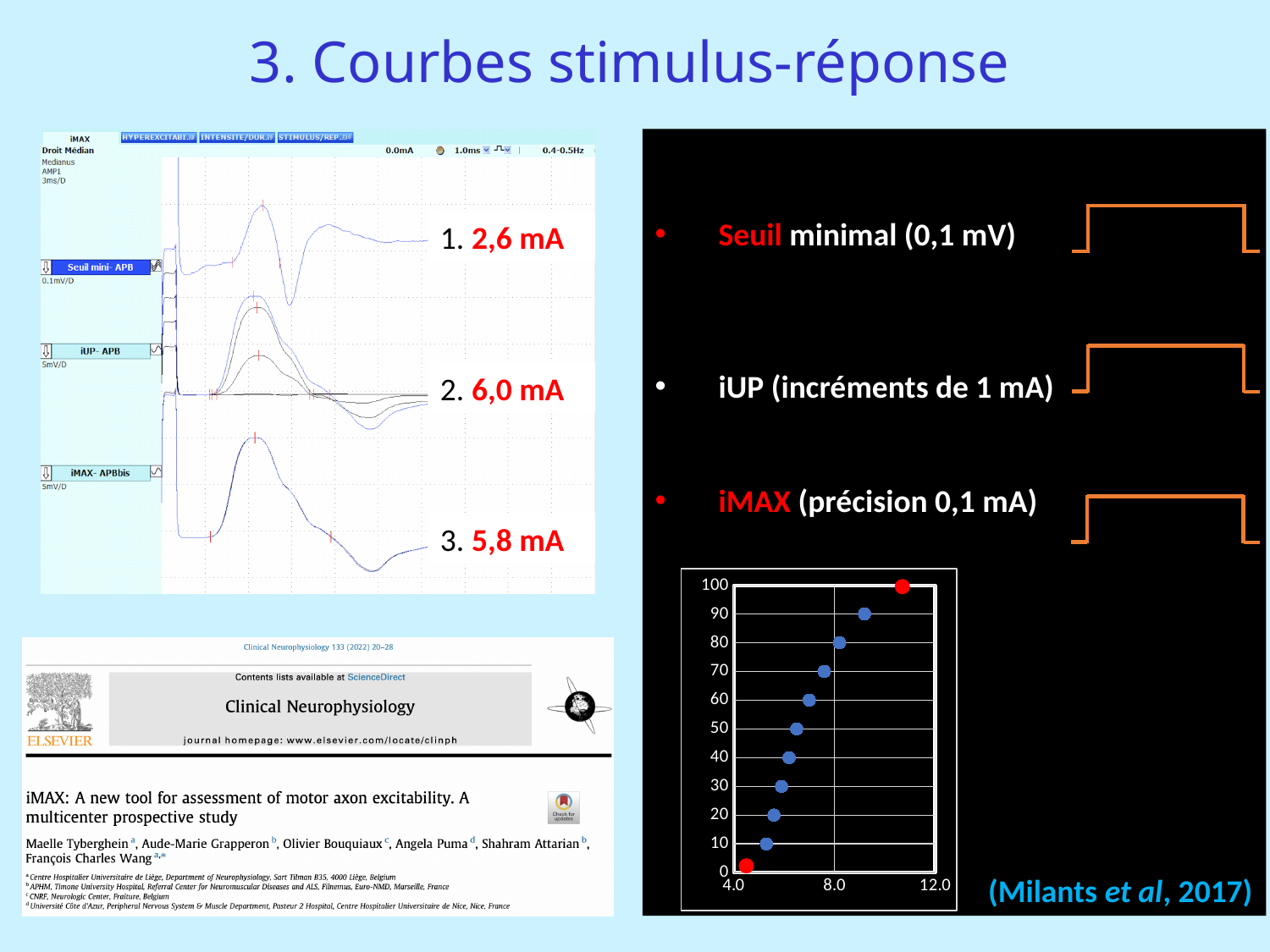
In the scatter chart at the bottom right, what is the lowest y value at which a point is plotted? 0 In the scatter chart at the bottom right, what are the three tick labels shown on the x axis? 4.0, 8.0, 12.0 In the scatter chart at the bottom right, what is the highest y value at which a point is plotted? 100 What kind of chart is shown at the bottom right of the slide? scatter chart In the scatter chart at the bottom right, is the x value of the point at y = 100 greater or less than 8.0? greater In the scatter chart at the bottom right, what is the highest value shown on the y axis? 100 In the scatter chart at the bottom right, how many data points are plotted? 11 In the scatter chart at the bottom right, which point has the highest y value: the red point at the top or the red point at the bottom? the red point at the top In the scatter chart at the bottom right, do the y values rise or fall as the x values increase? rise In the scatter chart at the bottom right, is the x value of the point at y = 50 greater or less than 8.0? less In the scatter chart at the bottom right, is the x value of the point at y = 0 greater or less than 8.0? less